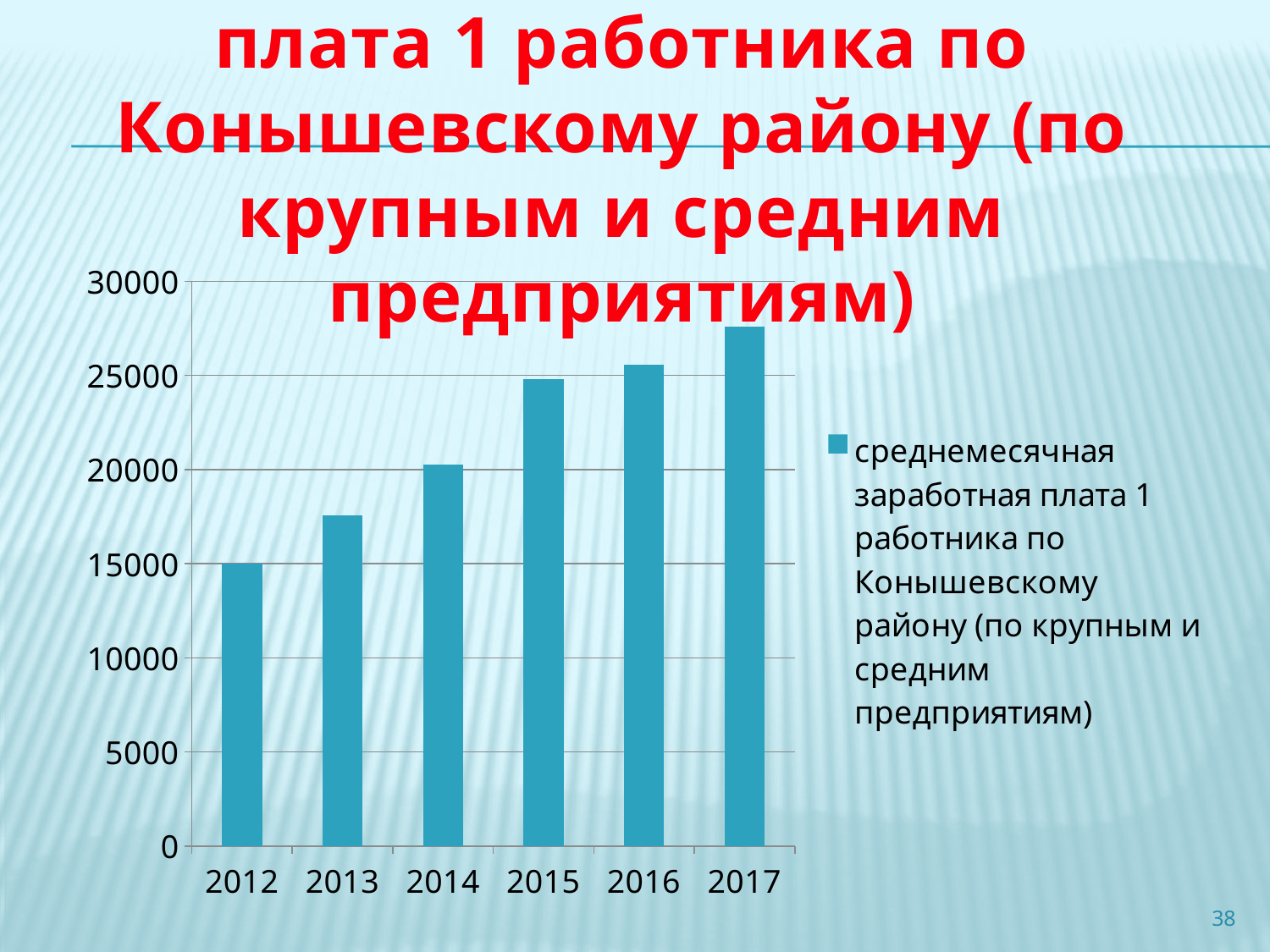
Which is larger, the value for 2014 or the value for 2015? 2015 Is the value for 2017 greater or less than 25000? greater What is the first year shown on the x axis of the chart? 2012 How many series does the chart legend list? 1 How many years are shown on the x axis of the chart? 6 Do the values rise or fall from 2012 to 2017? rise Is the value for 2013 greater or less than 20000? less What kind of chart is shown on the slide? bar chart Which year has the lowest average monthly wage in the chart? 2012 Which year has the highest average monthly wage in the chart? 2017